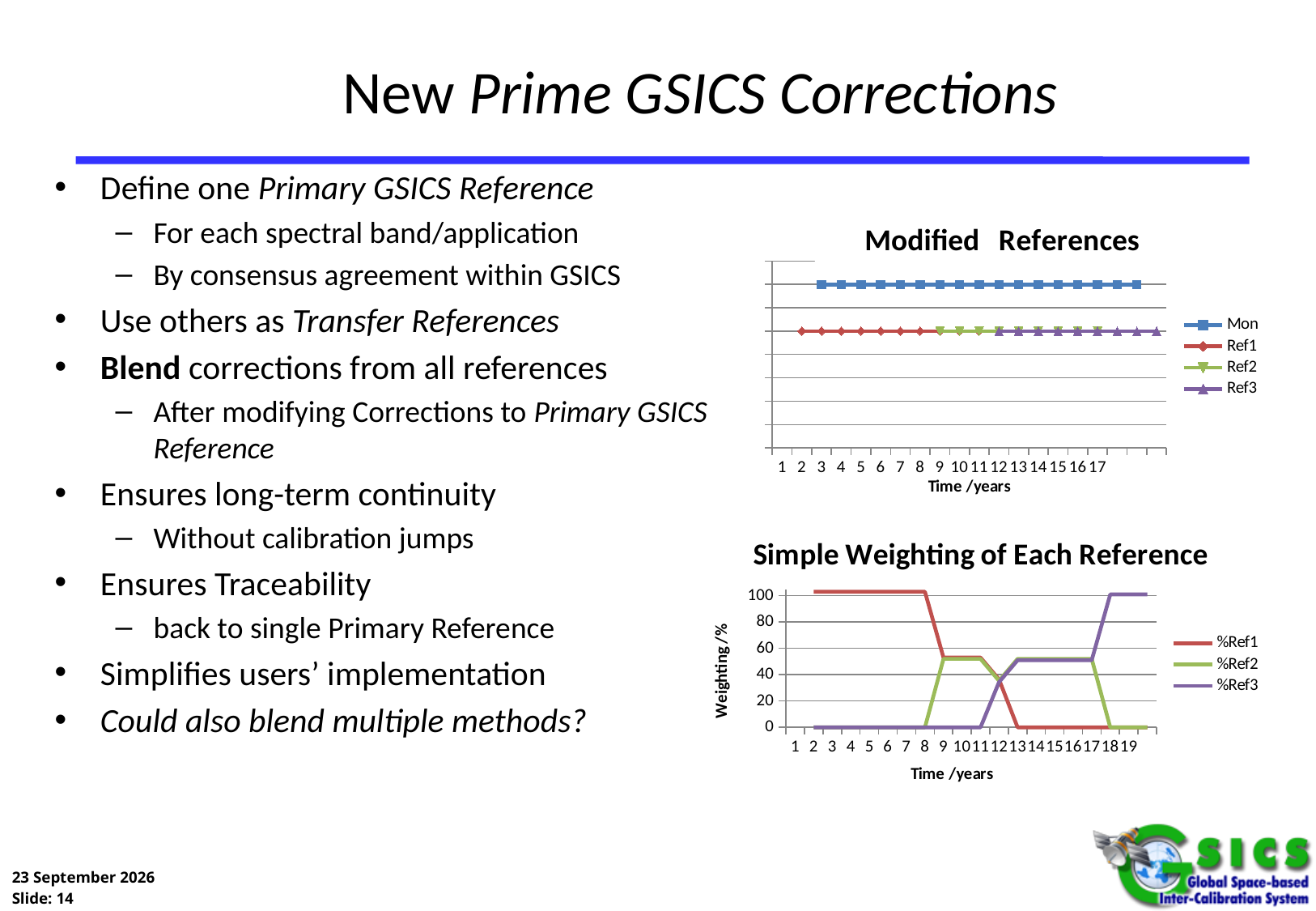
In the 'Simple Weighting of Each Reference' chart, which is larger at year 15, %Ref3 or %Ref1? %Ref3 How many series does the legend of the 'Simple Weighting of Each Reference' chart list? 3 In the 'Simple Weighting of Each Reference' chart, what is the value of %Ref3 at year 5? 0 In the 'Simple Weighting of Each Reference' chart, is the value of %Ref2 at year 15 greater or less than 40? greater How many series does the legend of the 'Modified References' chart list? 4 What is the y-axis label of the 'Simple Weighting of Each Reference' chart? Weighting / % What kind of chart is the 'Modified References' chart? line chart In the 'Simple Weighting of Each Reference' chart, does %Ref1 rise or fall along the x axis overall? fall In the 'Modified References' chart, which series is plotted highest on the chart? Mon What kind of chart is the 'Simple Weighting of Each Reference' chart? line chart